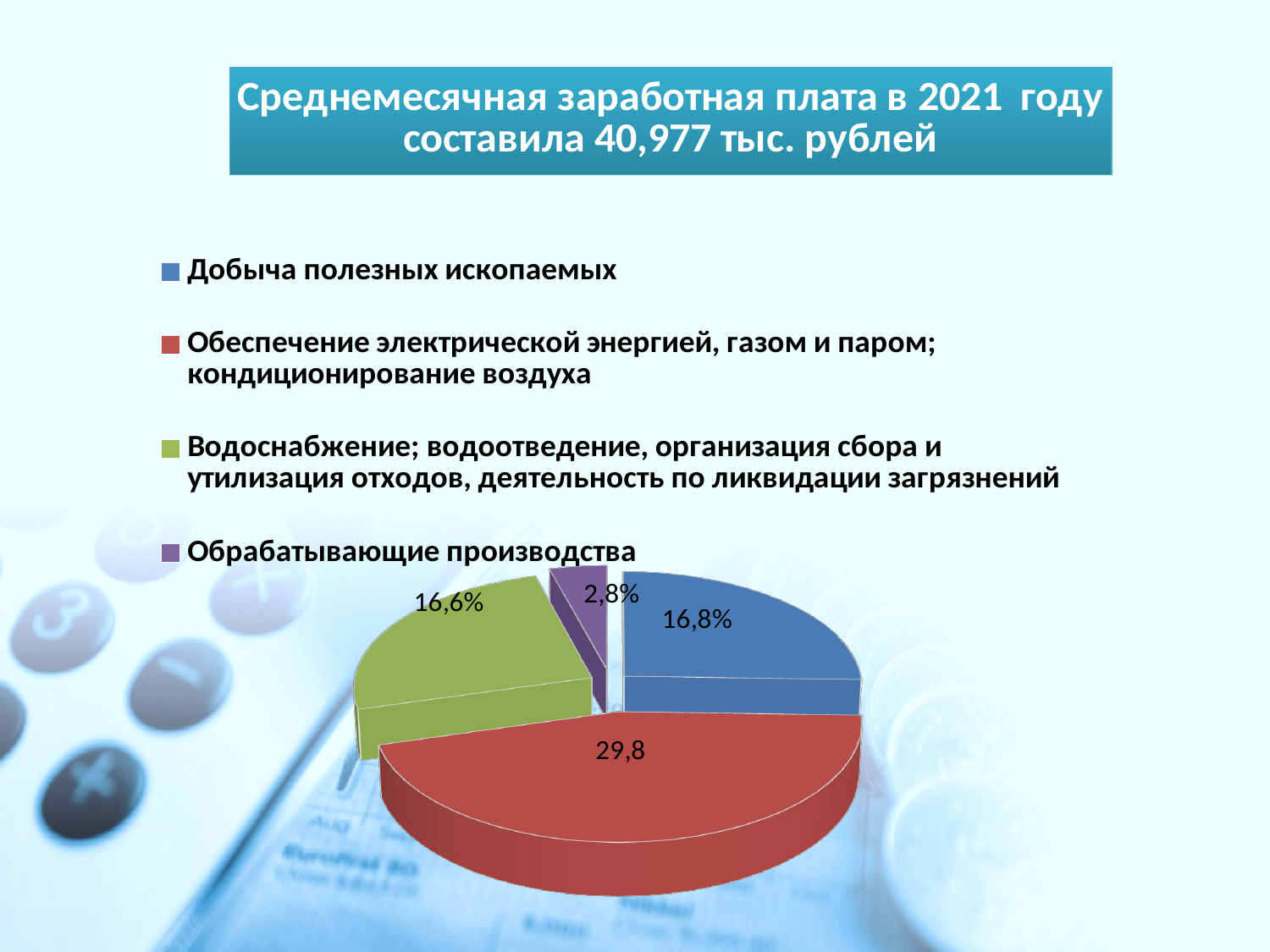
Which category has the smallest slice of the pie? Обрабатывающие производства Which is larger: the slice for Добыча полезных ископаемых or the slice for Обрабатывающие производства? Добыча полезных ископаемых How many categories does the pie chart show? 4 What is the value shown for Обеспечение электрической энергией, газом и паром; кондиционирование воздуха? 29,8 What is the value shown for Водоснабжение; водоотведение, организация сбора и утилизация отходов, деятельность по ликвидации загрязнений? 16,6% What is the value shown for Добыча полезных ископаемых? 16,8% According to the slide title, what was the average monthly salary in 2021? 40,977 тыс. рублей What colour is the slice for Обрабатывающие производства? purple What is the difference between the values for Добыча полезных ископаемых and Водоснабжение; водоотведение, организация сбора и утилизация отходов, деятельность по ликвидации загрязнений? 0,2% Which category has the largest slice of the pie? Обеспечение электрической энергией, газом и паром; кондиционирование воздуха What is the value shown for Обрабатывающие производства? 2,8% What kind of chart is shown on the slide? pie chart